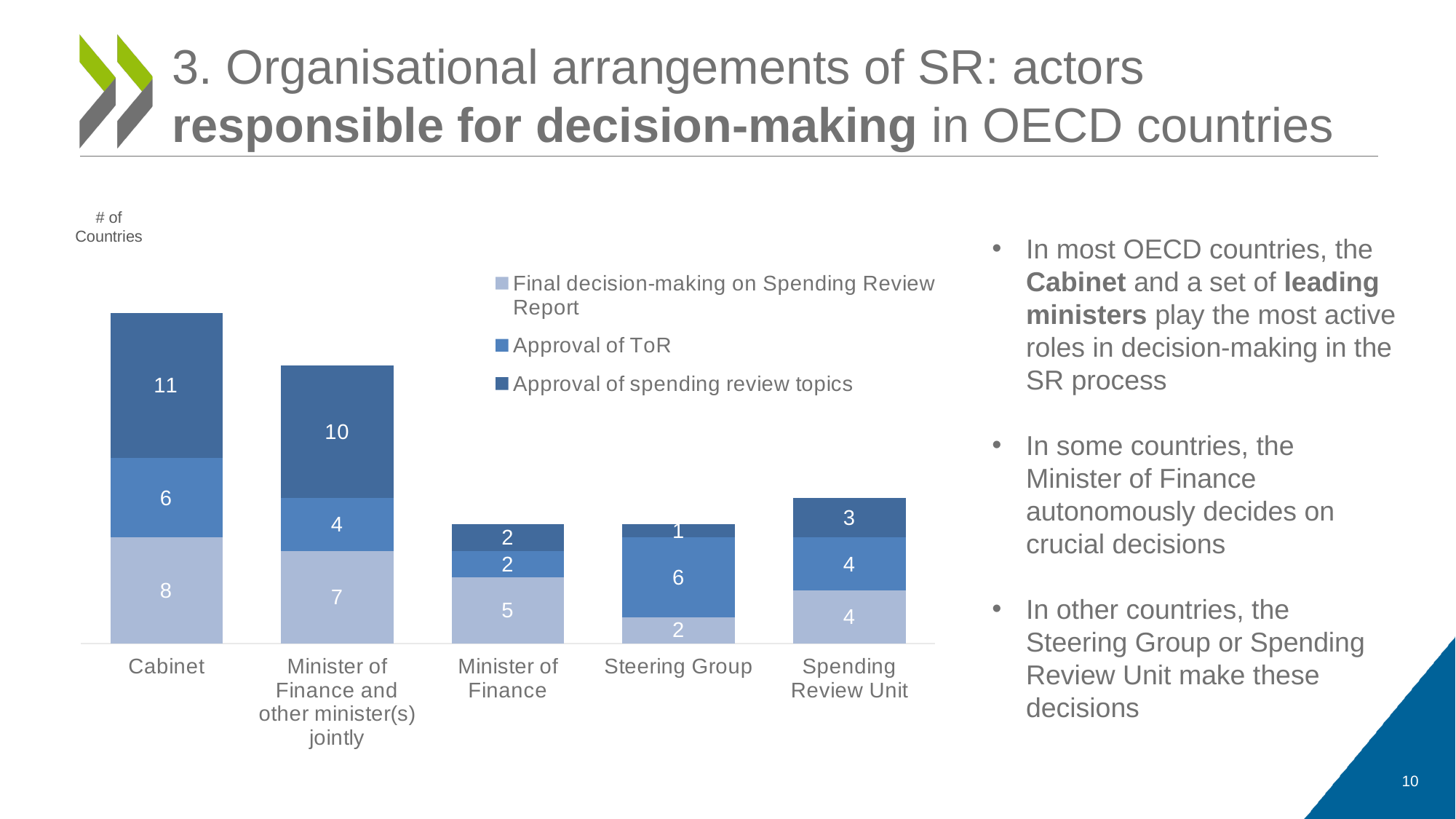
What is the value for 'Final decision-making on Spending Review Report' for Minister of Finance and other minister(s) jointly? 7 What is the total of the stacked bar for Cabinet? 25 What is the difference between the 'Approval of ToR' values for Cabinet and Minister of Finance? 4 What is the value for 'Approval of ToR' for Steering Group? 6 What kind of chart is shown on the slide? Stacked bar chart How many series does the chart's legend list? 3 What is the value for 'Approval of spending review topics' for Cabinet? 11 How many categories are shown on the x axis of the chart? 5 Which category has the lowest value for 'Final decision-making on Spending Review Report'? Steering Group What is the total of the stacked bar for Spending Review Unit? 11 Which is larger: the 'Approval of spending review topics' value for Spending Review Unit or for Steering Group? Spending Review Unit Which category has the highest value for 'Approval of spending review topics'? Cabinet